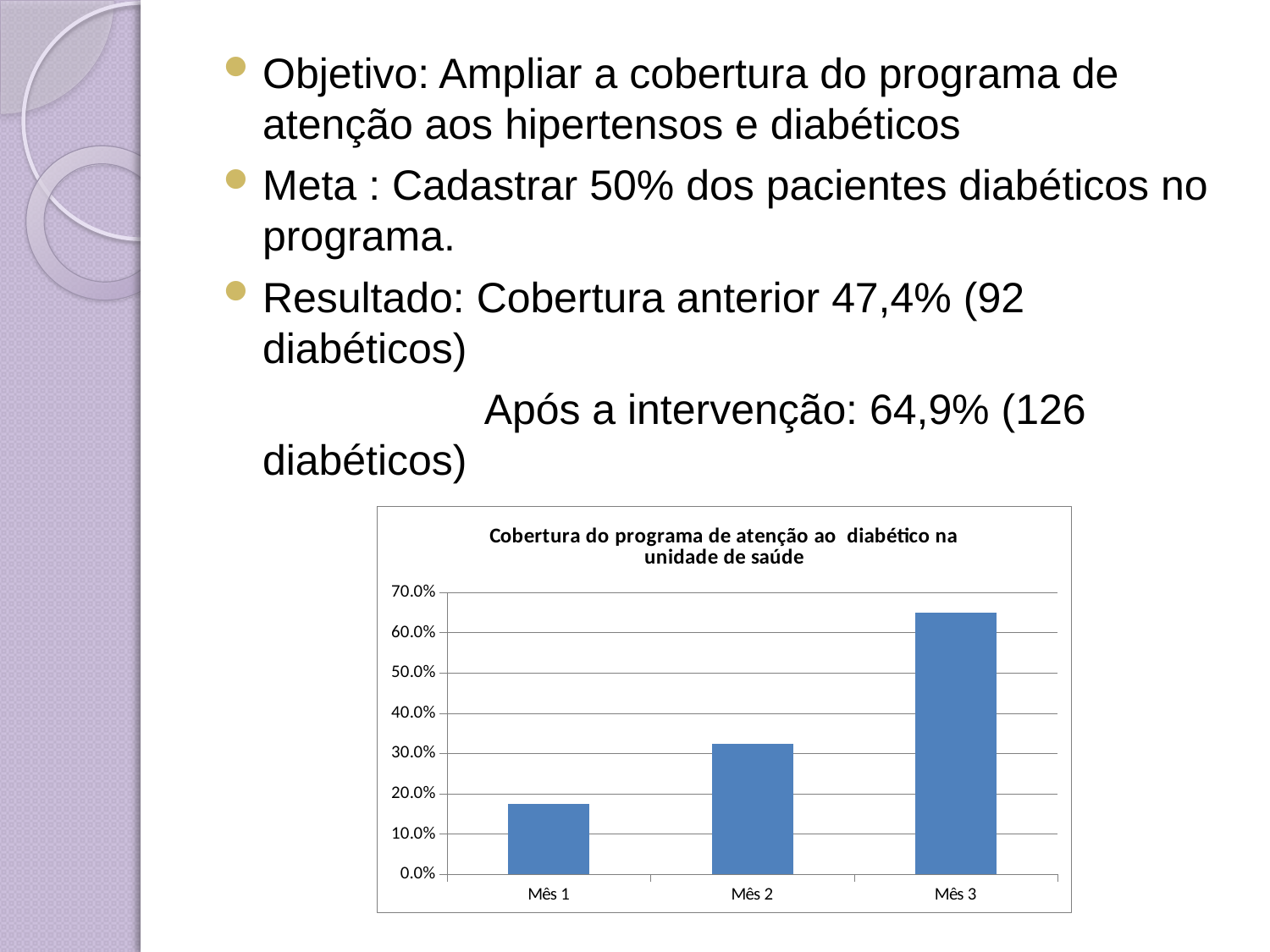
What is the title of the chart? Cobertura do programa de atenção ao diabético na unidade de saúde Is the value for Mês 2 greater or less than 30.0%? greater Which month has the lowest bar in the chart? Mês 1 Is the value for Mês 1 greater or less than 20.0%? less Which month has the highest bar in the chart? Mês 3 Is the value for Mês 1 greater or less than 10.0%? greater How many categories (months) are plotted on the x axis of the chart? 3 What kind of chart is shown on the slide? bar chart Which is larger, the value for Mês 2 or the value for Mês 3? Mês 3 Do the values rise or fall from Mês 1 to Mês 3? rise